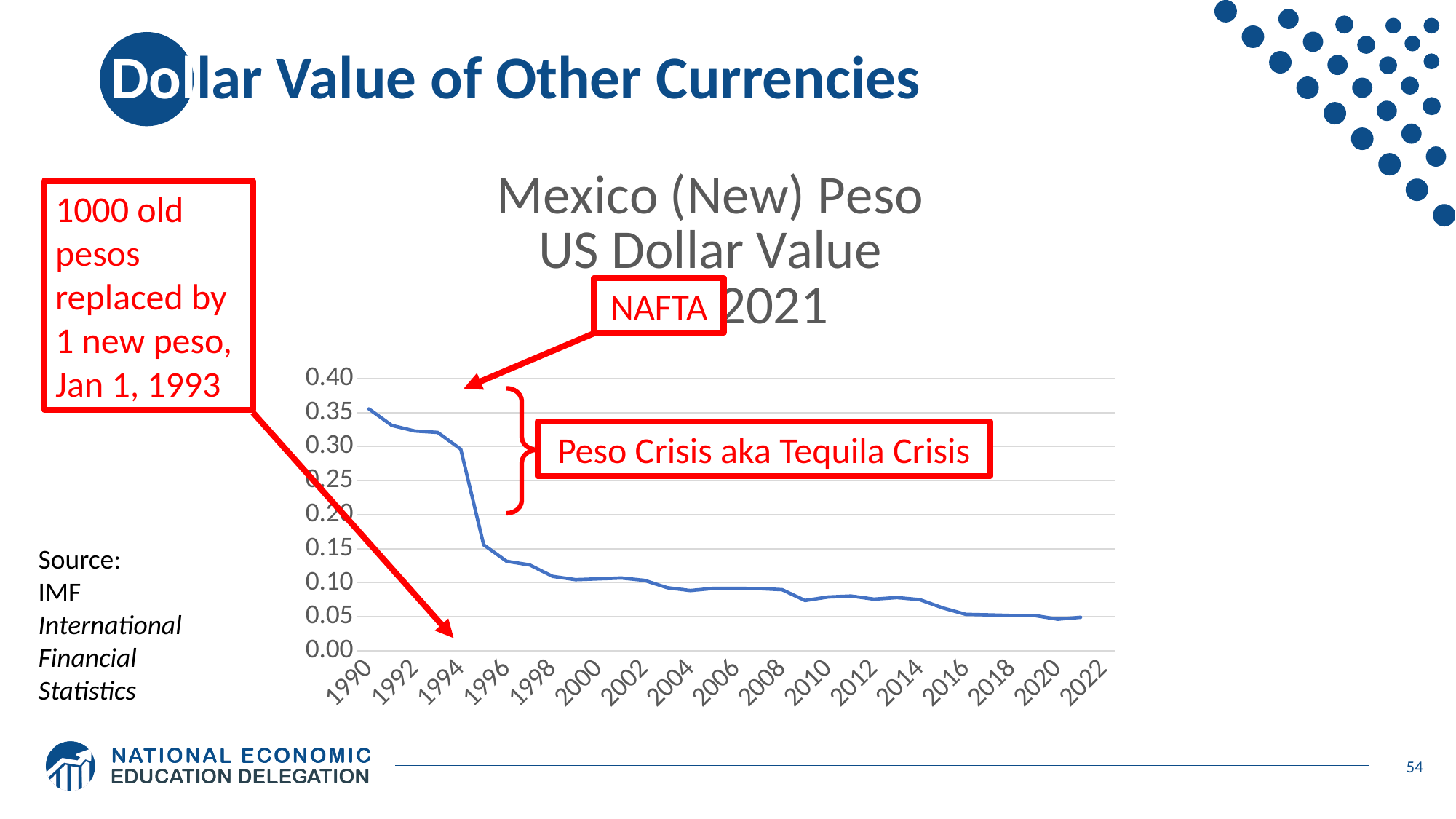
Is the value for 1994 greater or less than 0.25? greater Is the value for 1990 greater or less than 0.30? greater Is the value for 1996 greater or less than 0.20? less Does the US dollar value of the Mexican peso rise or fall from 1990 to 2021 overall? Fall What is the title of the chart? Mexico (New) Peso US Dollar Value 1990-2021 What is the source of the data cited on the slide? IMF International Financial Statistics In which year is the US dollar value of the peso highest? 1990 Which year has a higher value, 1994 or 1996? 1994 What kind of chart is shown on the slide? Line chart Which year has a higher value, 1990 or 2020? 1990